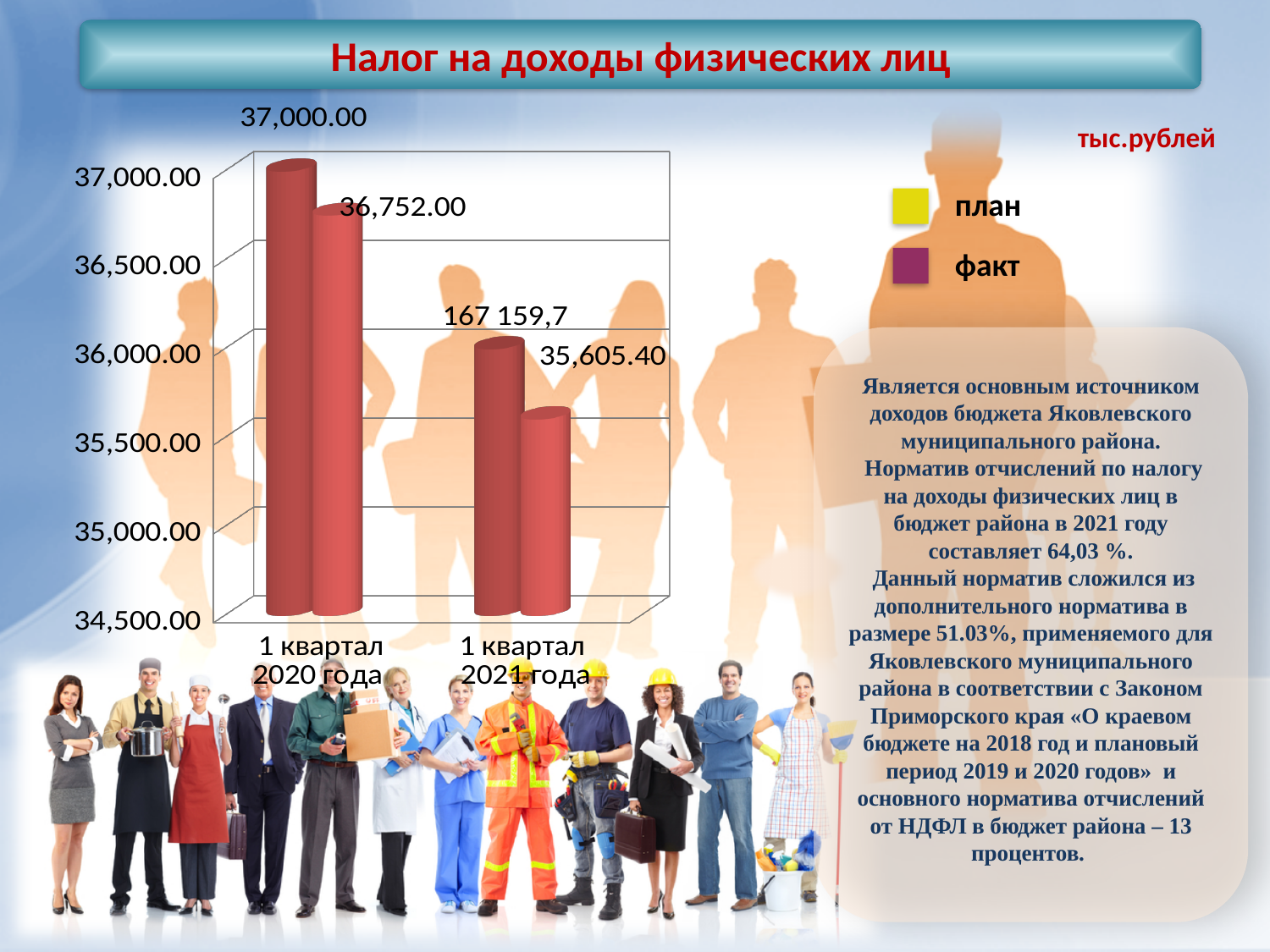
What kind of chart is shown on the slide? bar chart How many series does the legend list? 2 What is the difference between the plan and fact values for 1 квартал 2020 года? 248.00 Is the plan (план) value for 1 квартал 2021 года greater or less than 36,500.00? less What is the fact (факт) value for 1 квартал 2020 года? 36,752.00 Which bar shows the lowest value on the chart? факт, 1 квартал 2021 года What is the plan (план) value for 1 квартал 2020 года? 37,000.00 How many categories are shown on the x axis of the chart? 2 By how much does the fact value for 1 квартал 2020 года exceed the fact value for 1 квартал 2021 года? 1,146.60 What is the fact (факт) value for 1 квартал 2021 года? 35,605.40 Do the fact (факт) values rise or fall from 1 квартал 2020 года to 1 квартал 2021 года? fall Which quarter has the larger fact (факт) value, 1 квартал 2020 года or 1 квартал 2021 года? 1 квартал 2020 года